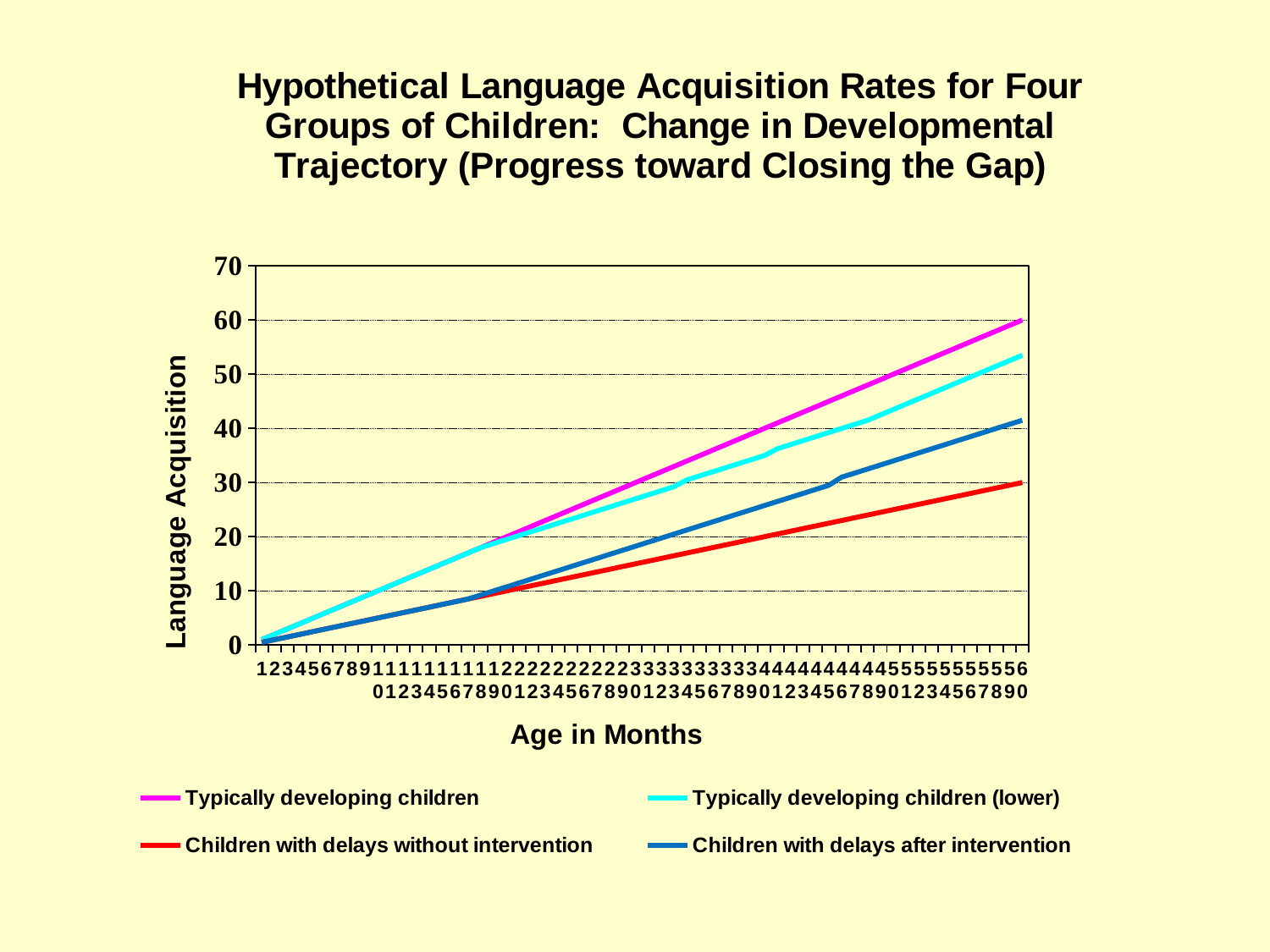
Which series has the highest value at 60 months? Typically developing children What is the label of the x axis? Age in Months Is the value for Children with delays without intervention at 60 months greater or less than 40? less Do the values for Typically developing children rise or fall as age in months increases? rise How many series does the legend list? 4 What kind of chart is shown on the slide? line chart Is the value for Typically developing children (lower) at 60 months greater or less than 50? greater What is the value for Typically developing children at 60 months? 60 What is the label of the y axis? Language Acquisition At 60 months, which is larger: Children with delays after intervention or Children with delays without intervention? Children with delays after intervention Which series has the lowest value at 60 months? Children with delays without intervention